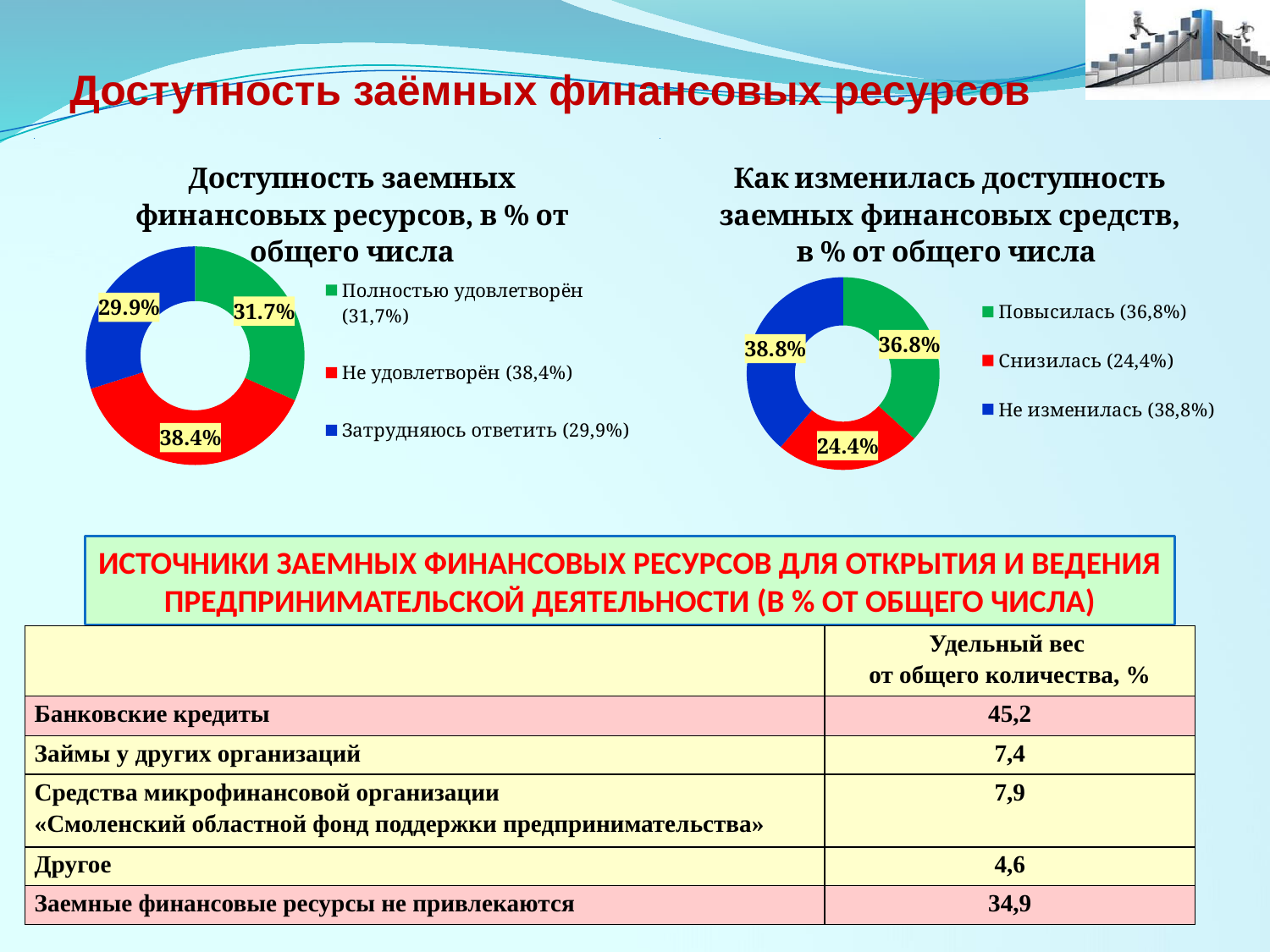
In the left chart 'Доступность заемных финансовых ресурсов, в % от общего числа', what share of respondents answered 'Не удовлетворён'? 38.4% In the right chart 'Как изменилась доступность заемных финансовых средств, в % от общего числа', what colour is the 'Не изменилась' segment? Blue In the right chart 'Как изменилась доступность заемных финансовых средств, в % от общего числа', what share of respondents answered 'Не изменилась'? 38.8% In the left chart 'Доступность заемных финансовых ресурсов, в % от общего числа', what share of respondents answered 'Полностью удовлетворён'? 31.7% In the right chart 'Как изменилась доступность заемных финансовых средств, в % от общего числа', which category has the smallest share? Снизилась In the right chart 'Как изменилась доступность заемных финансовых средств, в % от общего числа', which is larger: 'Повысилась' or 'Снизилась'? Повысилась What type of chart is the left chart 'Доступность заемных финансовых ресурсов, в % от общего числа'? Donut (pie) chart In the right chart 'Как изменилась доступность заемных финансовых средств, в % от общего числа', what share of respondents answered 'Снизилась'? 24.4% In the right chart 'Как изменилась доступность заемных финансовых средств, в % от общего числа', what is the difference in percentage points between 'Не изменилась' and 'Снизилась'? 14.4 In the left chart 'Доступность заемных финансовых ресурсов, в % от общего числа', which category has the smallest share? Затрудняюсь ответить In the left chart 'Доступность заемных финансовых ресурсов, в % от общего числа', how many categories does the legend list? 3 In the left chart 'Доступность заемных финансовых ресурсов, в % от общего числа', which category has the largest share? Не удовлетворён